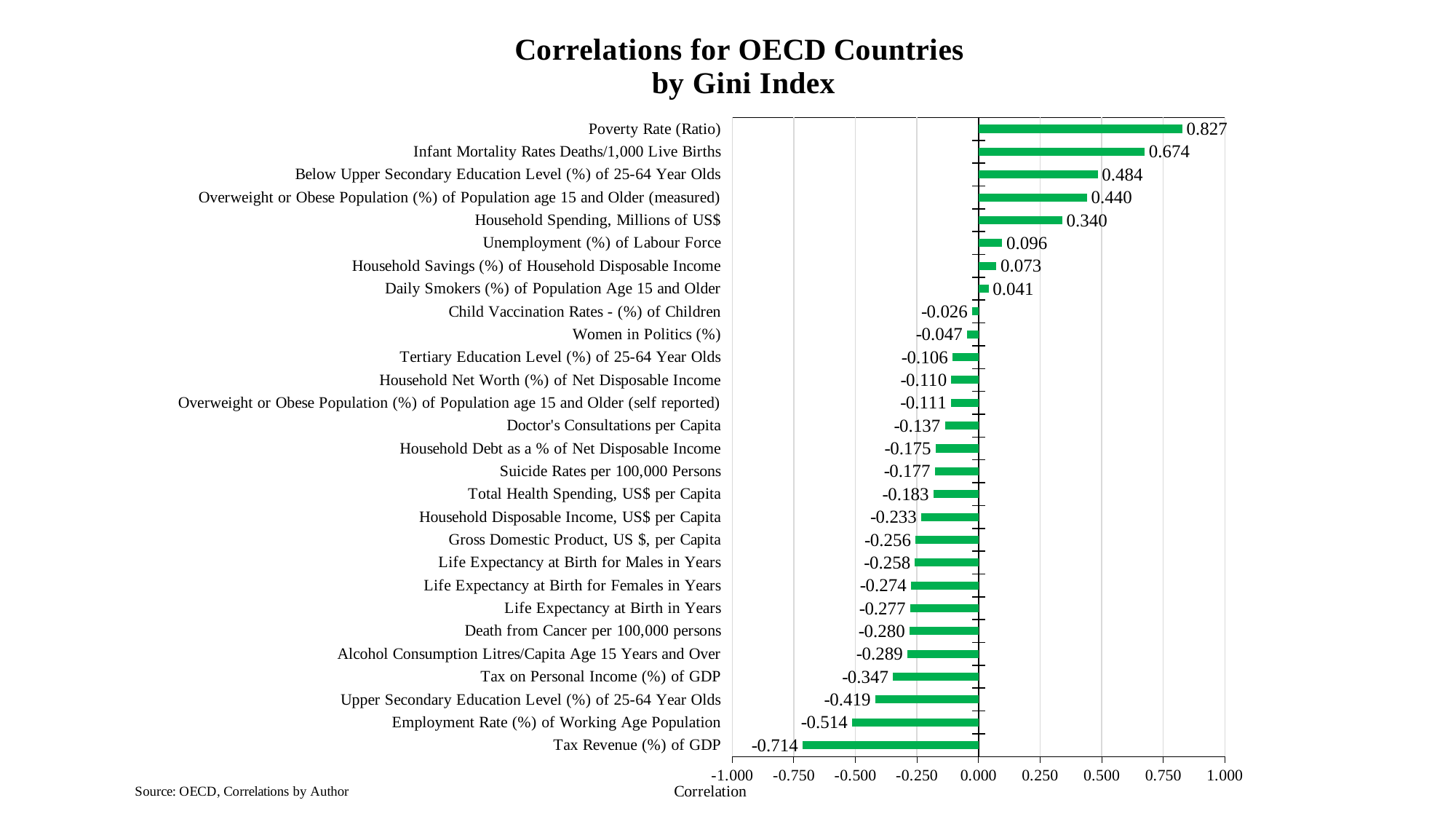
Which category has the highest correlation value? Poverty Rate (Ratio) Which has a larger correlation value: Household Spending, Millions of US$ or Unemployment (%) of Labour Force? Household Spending, Millions of US$ What is the correlation value for Unemployment (%) of Labour Force? 0.096 What is the correlation value for Poverty Rate (Ratio)? 0.827 What is the correlation value for Tax Revenue (%) of GDP? -0.714 Which category has the lowest correlation value? Tax Revenue (%) of GDP How many categories are plotted in the chart? 28 What is the difference between the correlation values for Employment Rate (%) of Working Age Population and Tax Revenue (%) of GDP? 0.200 What is the correlation value for Life Expectancy at Birth for Females in Years? -0.274 What is the difference between the correlation values for Poverty Rate (Ratio) and Infant Mortality Rates Deaths/1,000 Live Births? 0.153 What kind of chart is shown on the slide? Bar chart What is the title of the chart? Correlations for OECD Countries by Gini Index